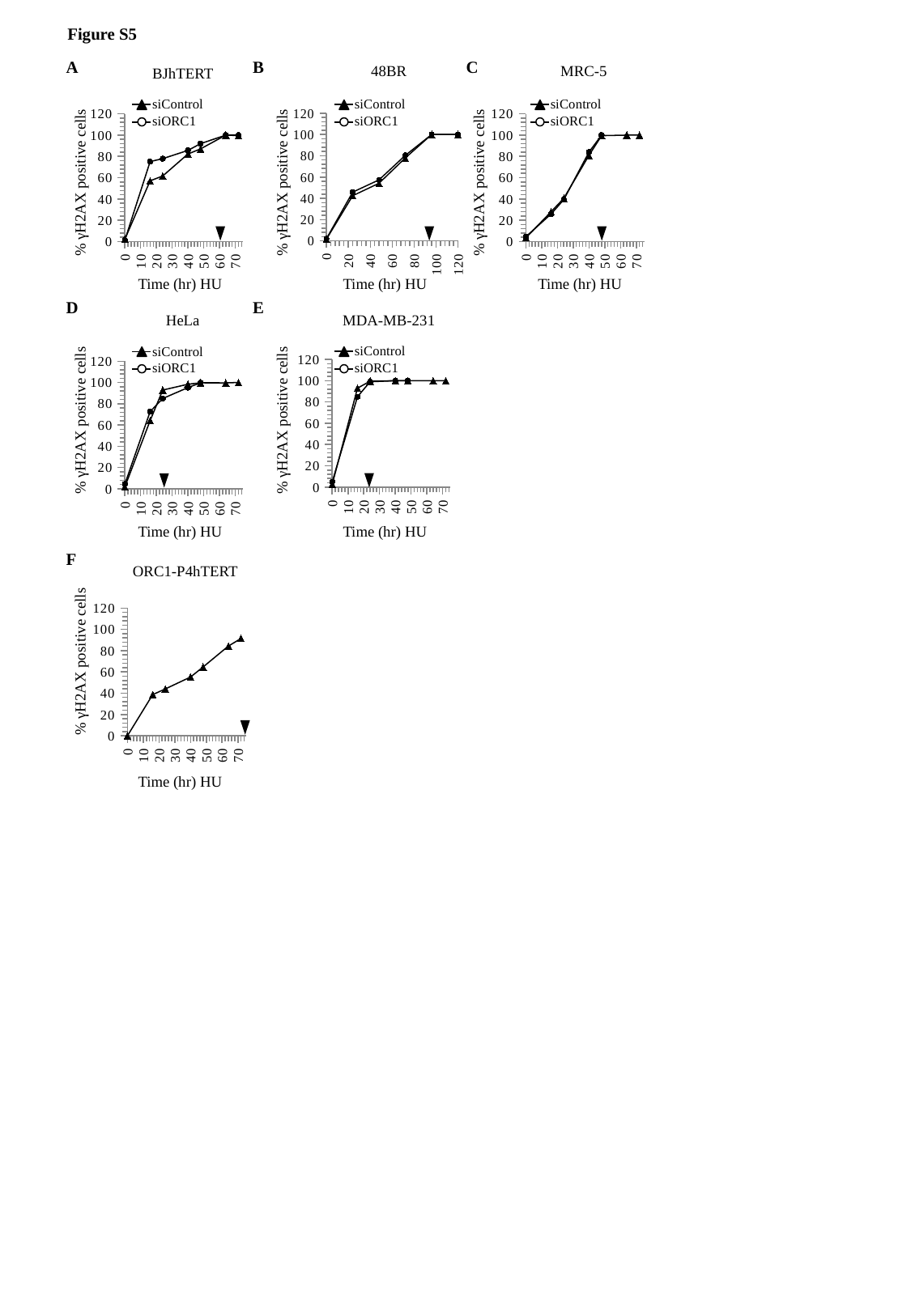
What is the x-axis label of the ORC1-P4hTERT chart (panel F)? Time (hr) HU In the ORC1-P4hTERT chart (panel F), do the values rise or fall along the x axis? rise In the ORC1-P4hTERT chart (panel F), is the value at the second time point (about 16 hr) greater or less than 60? less In the ORC1-P4hTERT chart (panel F), is the value at the last time point (about 72 hr) greater or less than 80? greater What kind of chart is the BJhTERT chart (panel A)? line chart In the MDA-MB-231 chart (panel E), is the siControl value at 40 hr greater or less than 80? greater In the MRC-5 chart (panel C), do the values rise or fall as time increases? rise How many series does the legend of the 48BR chart (panel B) list? 2 In the BJhTERT chart (panel A), which series is higher at the second time point (around 16 hr): siControl or siORC1? siORC1 What is the y-axis label of the HeLa chart (panel D)? % γH2AX positive cells